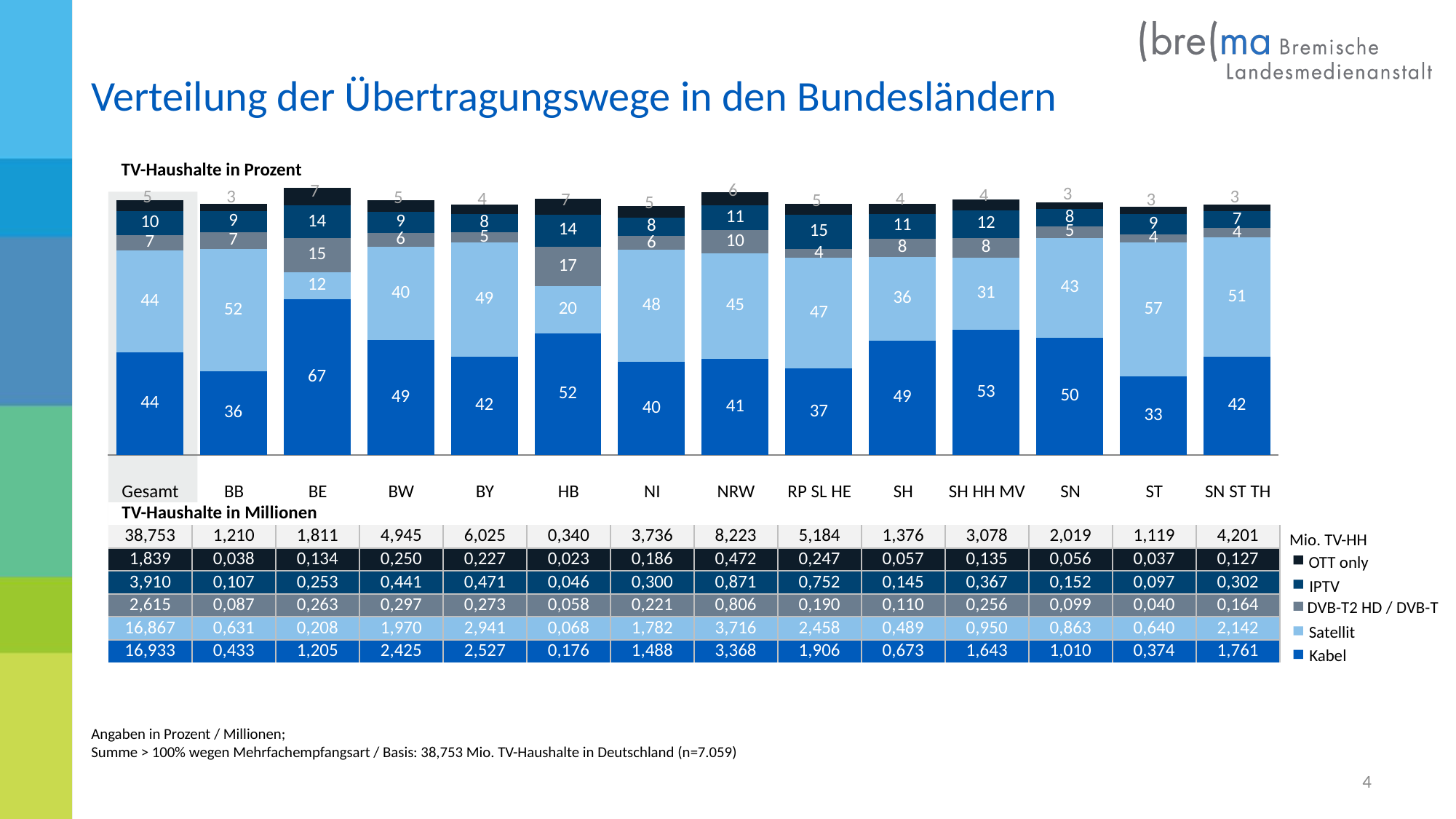
Which category has the lowest Kabel share in the TV-Haushalte in Prozent chart? ST Which category has the lowest Satellit share in the TV-Haushalte in Prozent chart? BE What is the Kabel share for BE in the TV-Haushalte in Prozent chart? 67 How many series does the legend of the TV-Haushalte in Prozent chart list? 5 What is the DVB-T2 HD / DVB-T share for HB in the TV-Haushalte in Prozent chart? 17 For BB in the TV-Haushalte in Prozent chart, which is larger: the Satellit share or the Kabel share? Satellit What kind of chart is the TV-Haushalte in Prozent chart? Stacked bar chart What is the total of the stacked bar for Gesamt in the TV-Haushalte in Prozent chart? 110 How many categories are shown along the x axis of the TV-Haushalte in Prozent chart? 14 Which category has the highest Satellit share in the TV-Haushalte in Prozent chart? ST What is the difference between the Kabel share for BE and the Kabel share for BB in the TV-Haushalte in Prozent chart? 31 Which category has the highest Kabel share in the TV-Haushalte in Prozent chart? BE